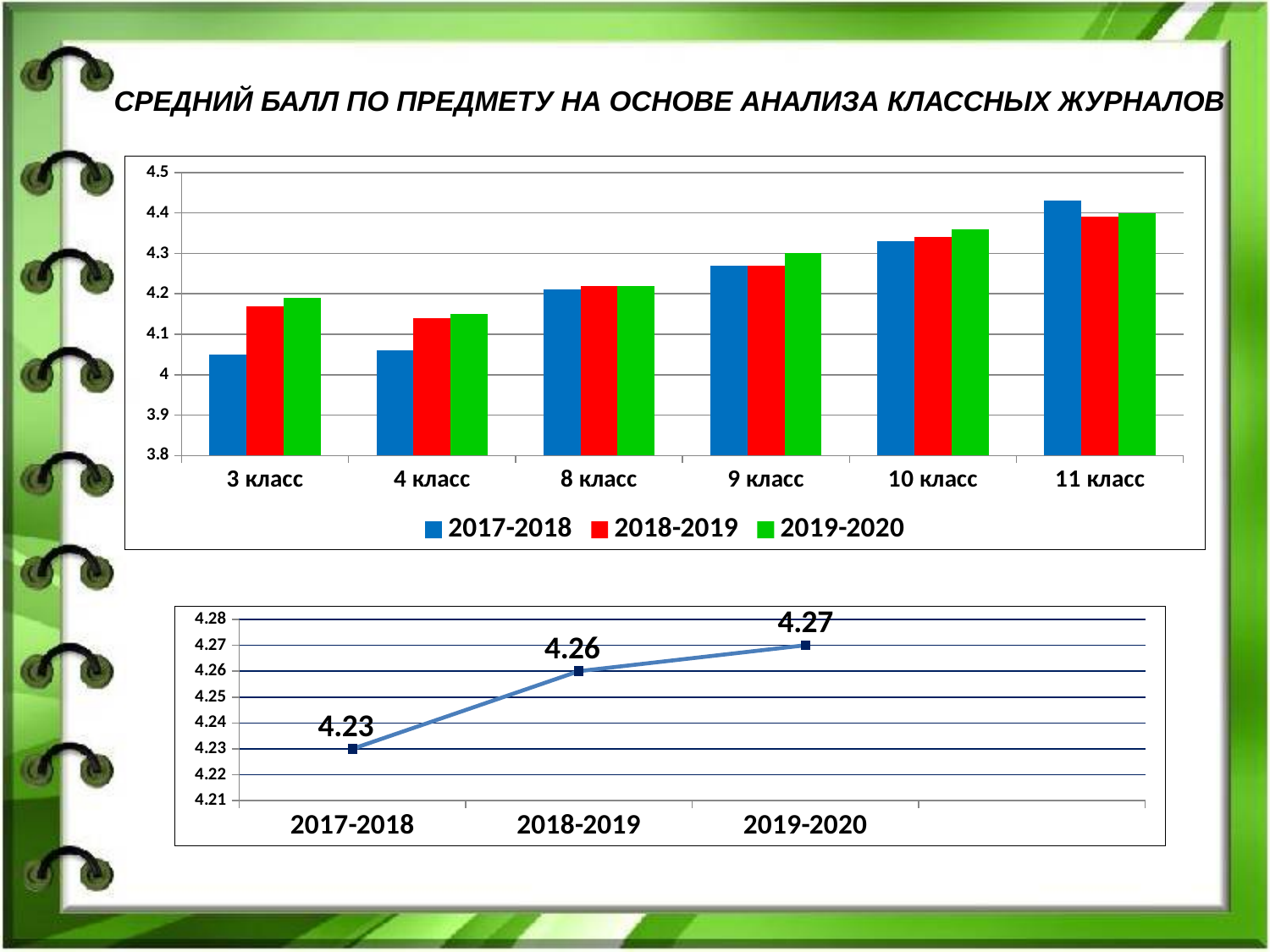
In the top chart, is the value for 3 класс in 2017-2018 greater or less than 4.1? less In the bottom chart, which year has the lowest value? 2017-2018 In the top chart, how many series does the legend list? 3 In the bottom chart, what is the value for 2019-2020? 4.27 In the bottom chart, what is the value for 2017-2018? 4.23 In the bottom chart, do the values rise or fall from 2017-2018 to 2019-2020? rise In the top chart, is the value for 11 класс in 2017-2018 greater or less than 4.4? greater In the top chart, how many class categories are shown on the x axis? 6 In the top chart, which class has the highest bar overall? 11 класс In the bottom chart, what is the difference between the 2019-2020 value and the 2017-2018 value? 0.04 In the top chart, what kind of chart is it? bar chart In the top chart, which is larger for 3 класс: the 2017-2018 value or the 2019-2020 value? 2019-2020